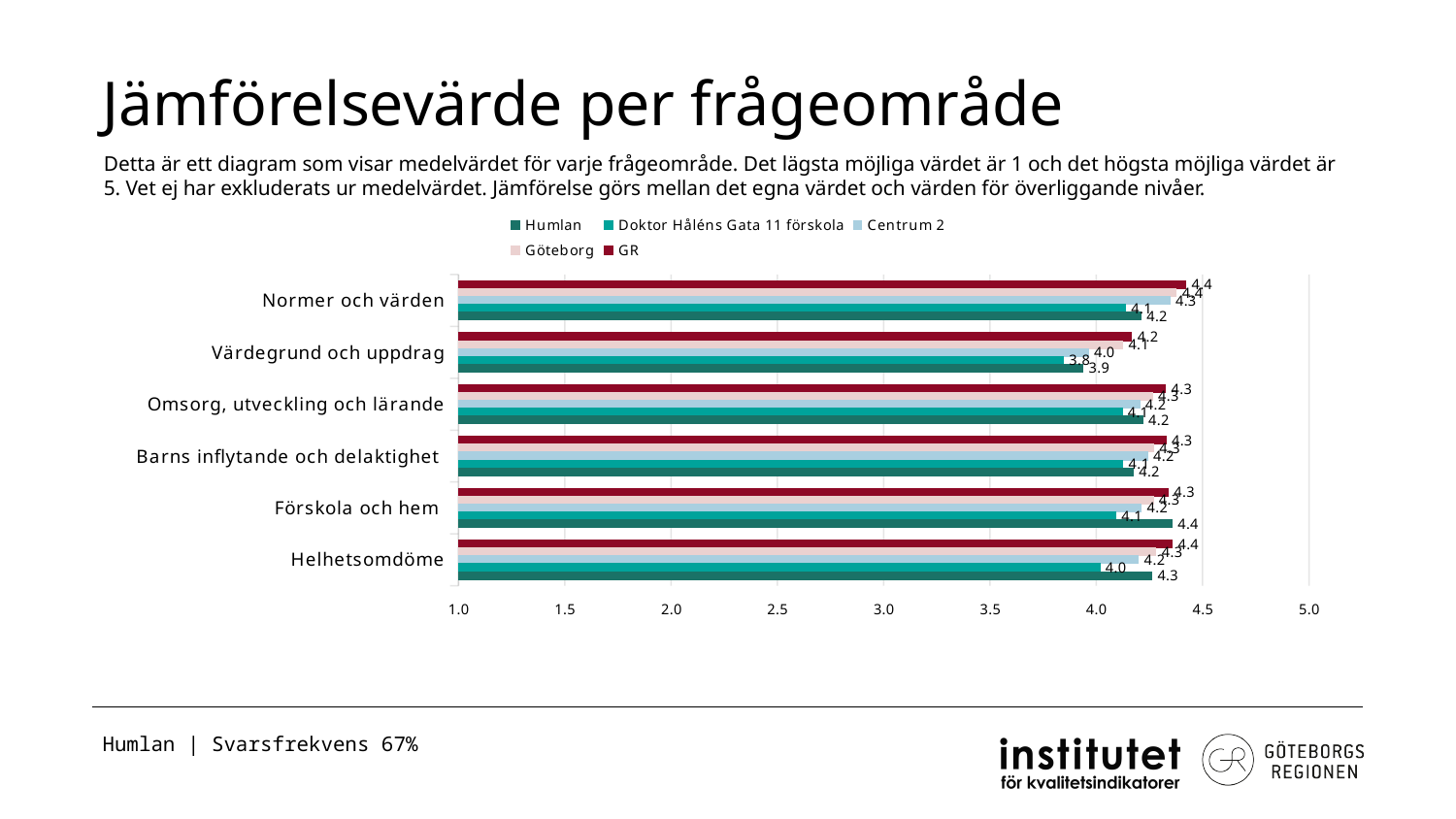
What kind of chart is shown on the slide? bar chart What is the difference between Humlan's value for Förskola och hem and its value for Värdegrund och uppdrag? 0.5 In the category Helhetsomdöme, which is larger: the value for Humlan or the value for Doktor Håléns Gata 11 förskola? Humlan What is the title of the slide? Jämförelsevärde per frågeområde How many question areas (categories) are shown on the y axis? 6 In which category does Humlan have its lowest value? Värdegrund och uppdrag What is the value for Doktor Håléns Gata 11 förskola in the category Värdegrund och uppdrag? 3.8 What is the value for Humlan in the category Helhetsomdöme? 4.3 What is the value for Humlan in the category Förskola och hem? 4.4 What is the value for Humlan in the category Värdegrund och uppdrag? 3.9 How many series does the legend list? 5 In which category does Humlan have its highest value? Förskola och hem